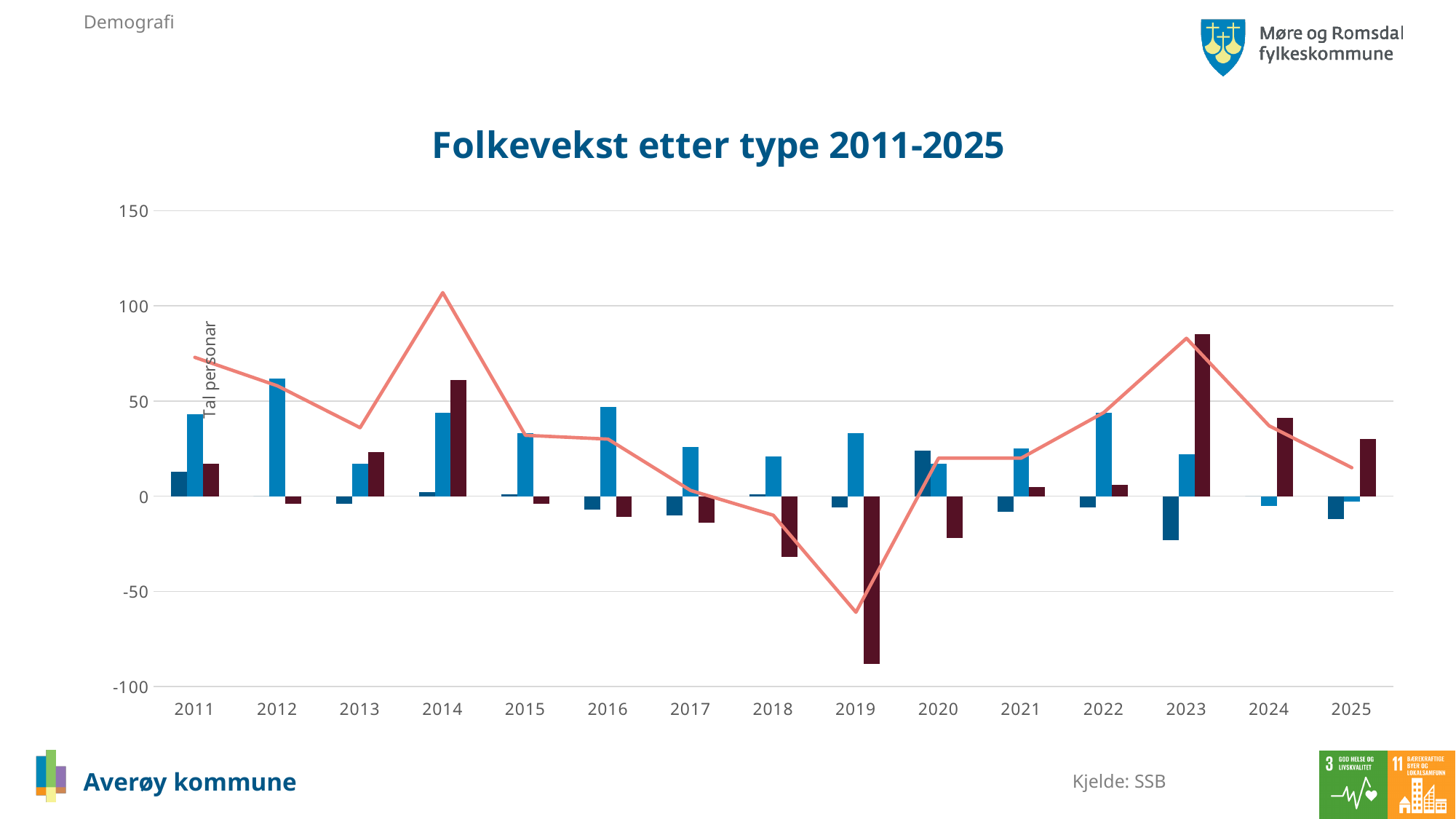
In which year does the line series reach its highest value? 2014 What label is shown on the vertical axis of the chart? Tal personar Is the value of the dark red bar for 2023 greater or less than 50? greater Is the value of the line series for 2019 greater or less than -50? less Is the value of the dark red bar for 2019 greater or less than -50? less Does the line series rise or fall from 2023 to 2025? fall In which year does the line series reach its lowest value? 2019 What is the title of the chart? Folkevekst etter type 2011-2025 What kind of chart is shown on the slide? Combined bar and line chart How many years are shown along the x axis of the chart? 15 Does the line series rise or fall from 2019 to 2023? rise